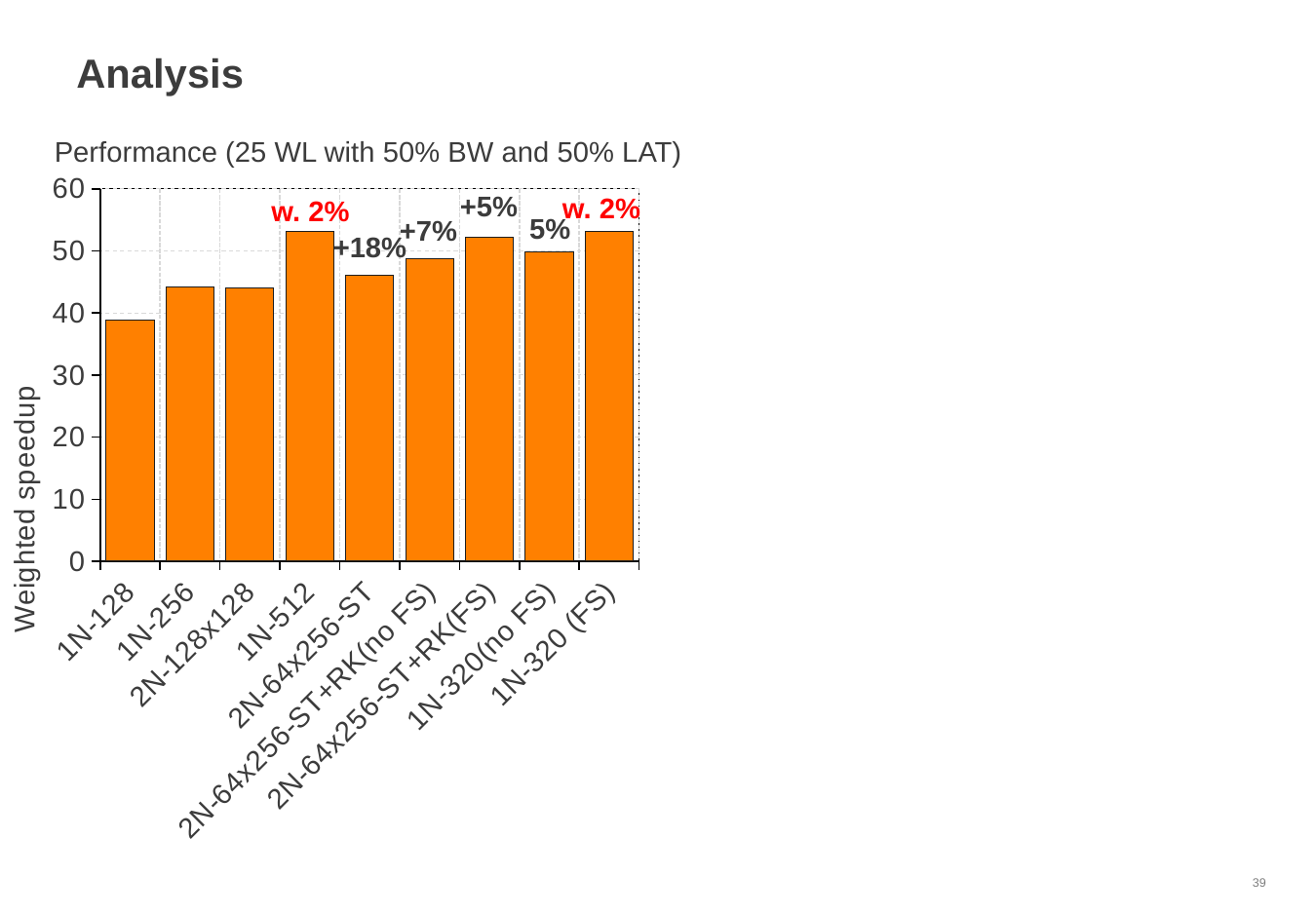
Is the weighted speedup for 1N-512 greater or less than 50? greater Which has a higher weighted speedup, 1N-128 or 1N-256? 1N-256 Which has a higher weighted speedup, 2N-64x256-ST+RK(no FS) or 2N-64x256-ST+RK(FS)? 2N-64x256-ST+RK(FS) How many categories are plotted on the x axis of the chart? 9 Which has a higher weighted speedup, 1N-512 or 2N-64x256-ST? 1N-512 Is the weighted speedup for 2N-64x256-ST+RK(FS) greater or less than 50? greater Is the weighted speedup for 1N-256 greater or less than 40? greater What is the label of the y axis of the chart? Weighted speedup What percentage annotation is printed above the 2N-64x256-ST bar? +18% Which category has the lowest weighted speedup? 1N-128 What kind of chart is shown on the slide? bar chart